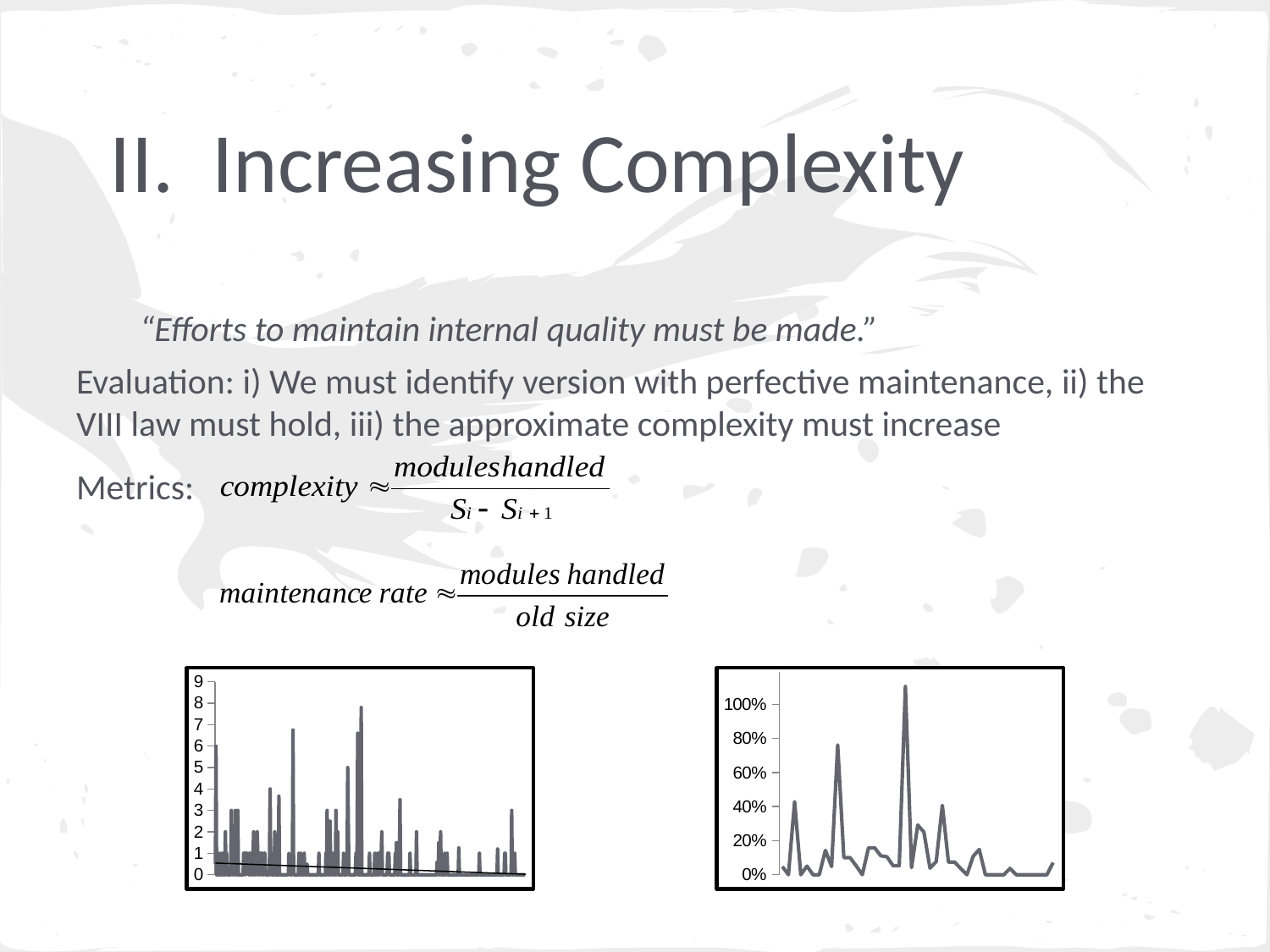
What is the highest tick label on the y axis of the chart on the right? 100% In the chart on the right, is the highest peak of the line greater or less than 100%? greater In the chart on the left, does the straight trend line rise or fall from left to right? fall What is the highest tick label on the y axis of the chart on the left? 9 What kind of chart is the chart on the left of the slide? line chart How many charts are shown on the slide? 2 In the chart on the right, is the second-highest peak of the line greater or less than 60%? greater In the chart on the left, is the highest peak of the line greater or less than 7? greater What kind of chart is the chart on the right of the slide? line chart